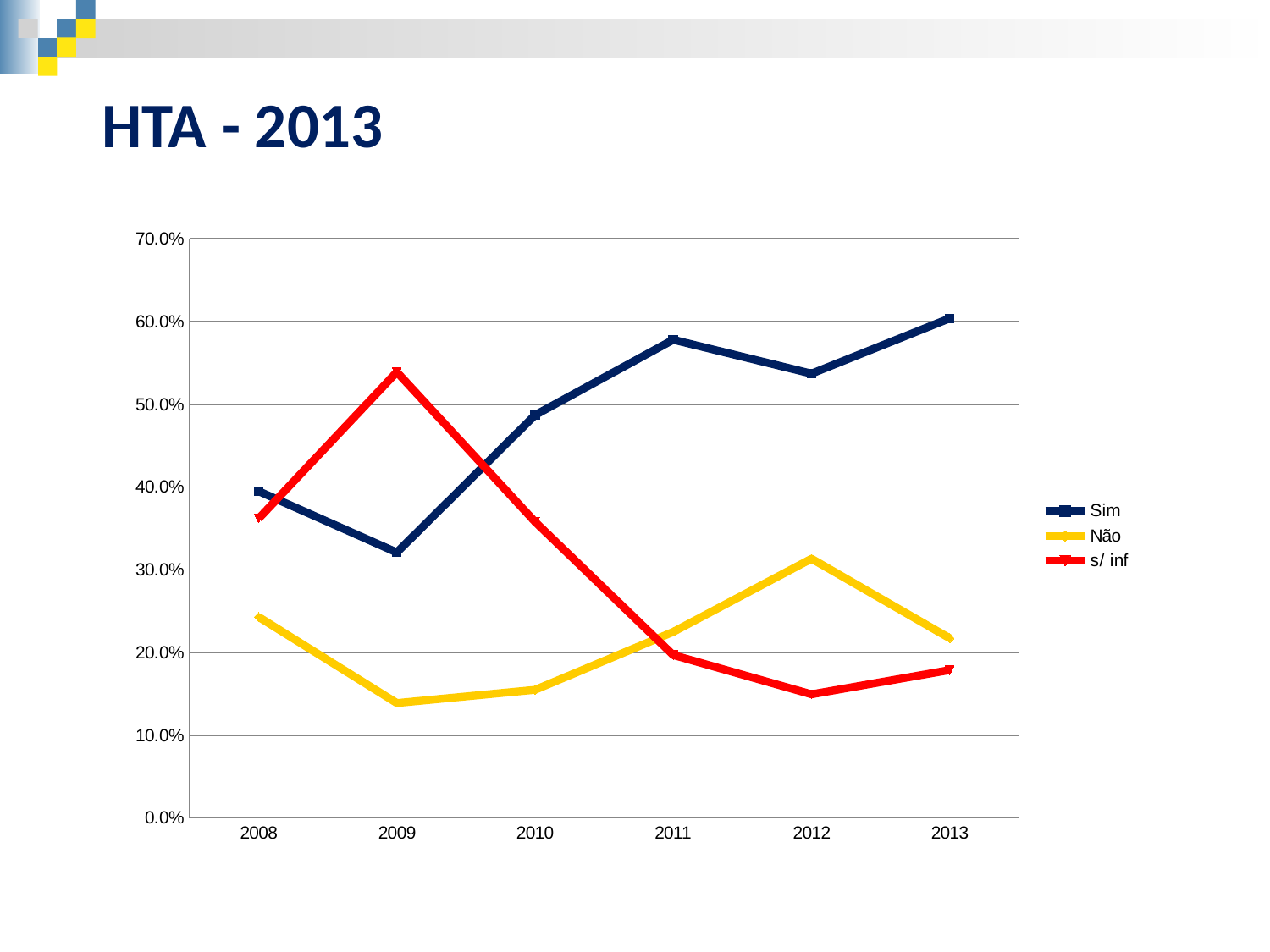
What is the title of the slide? HTA - 2013 In which year does the s/ inf series reach its highest value? 2009 How many series does the legend list? 3 In 2012, which series has the larger value, Não or s/ inf? Não How many years are shown on the x axis? 6 Is the value for s/ inf in 2009 greater or less than 50.0%? greater Does the s/ inf series rise or fall from 2009 to 2012? fall In which year does the s/ inf series reach its lowest value? 2012 Is the value for Sim in 2009 greater or less than 40.0%? less Is the value for Sim in 2011 greater or less than 50.0%? greater What kind of chart is shown on the slide? line chart